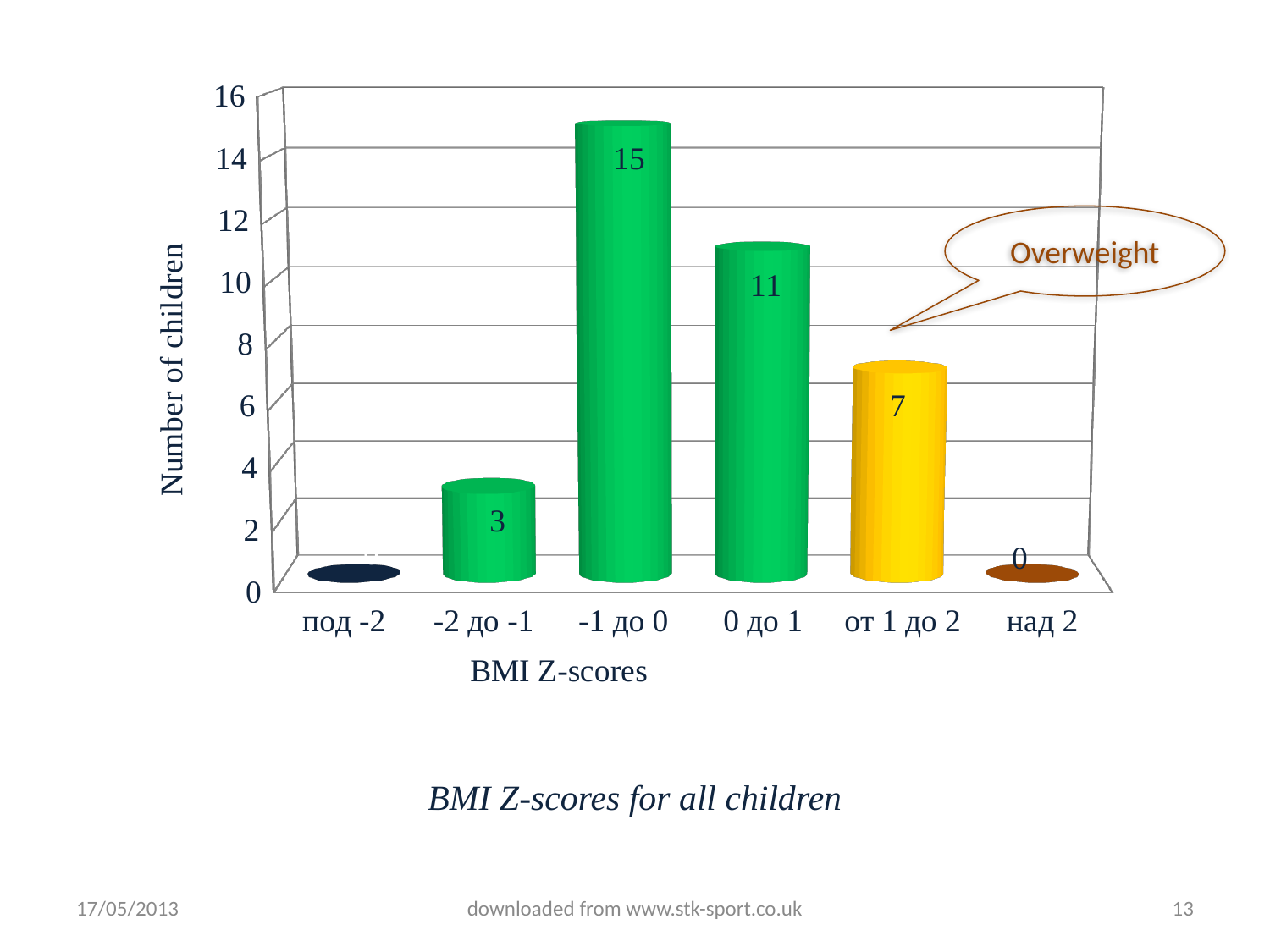
Which BMI Z-score category has the highest number of children? -1 до 0 What is the number of children in the -2 до -1 category? 3 What is the number of children in the -1 до 0 BMI Z-score category? 15 What is the number of children in the от 1 до 2 category? 7 What is the difference in number of children between the -1 до 0 and от 1 до 2 categories? 8 Which category does the 'Overweight' callout point to? от 1 до 2 What is the number of children in the 0 до 1 category? 11 What kind of chart is shown on the slide? Bar chart How many BMI Z-score categories are shown on the x axis? 6 Which category has more children, 0 до 1 or от 1 до 2? 0 до 1 What is the difference in number of children between the -1 до 0 and 0 до 1 categories? 4 What is the number of children in the над 2 category? 0